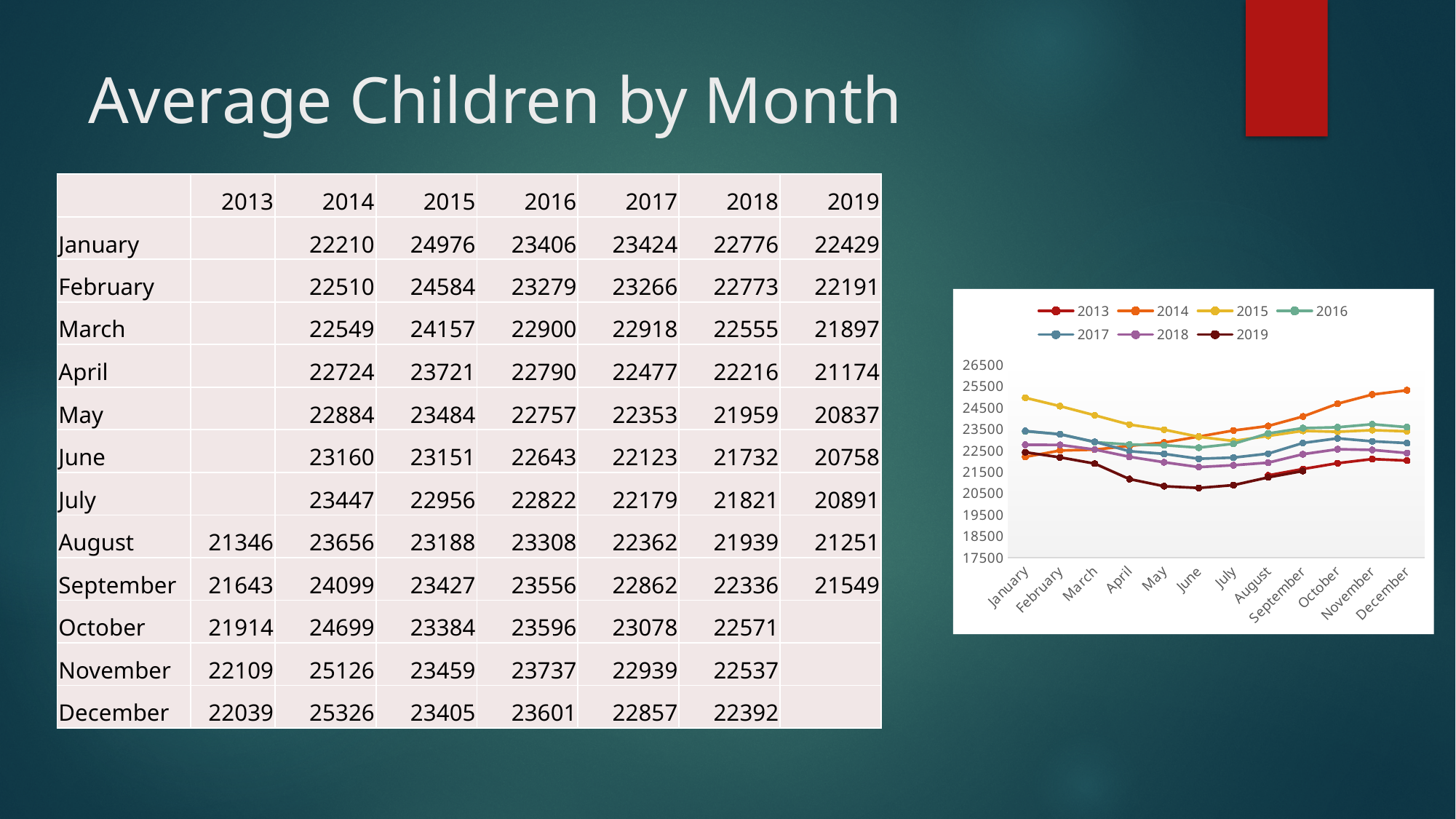
What colour is the 2014 series line in the chart? orange How many series does the chart's legend list? 7 Is the value for 2019 in June greater or less than 21500? less What is the difference between the 2015 and 2014 values in January? 2766 Which year has the highest value in December? 2014 Which is larger in November, the value for 2016 or the value for 2017? 2016 What is the value for 2019 in June? 20758 How many months are shown along the x axis of the chart? 12 Does the 2014 series generally rise or fall from January to December? rise What is the value for 2014 in December? 25326 What kind of chart is shown on the slide? line chart In which month does the 2019 series reach its lowest value? June